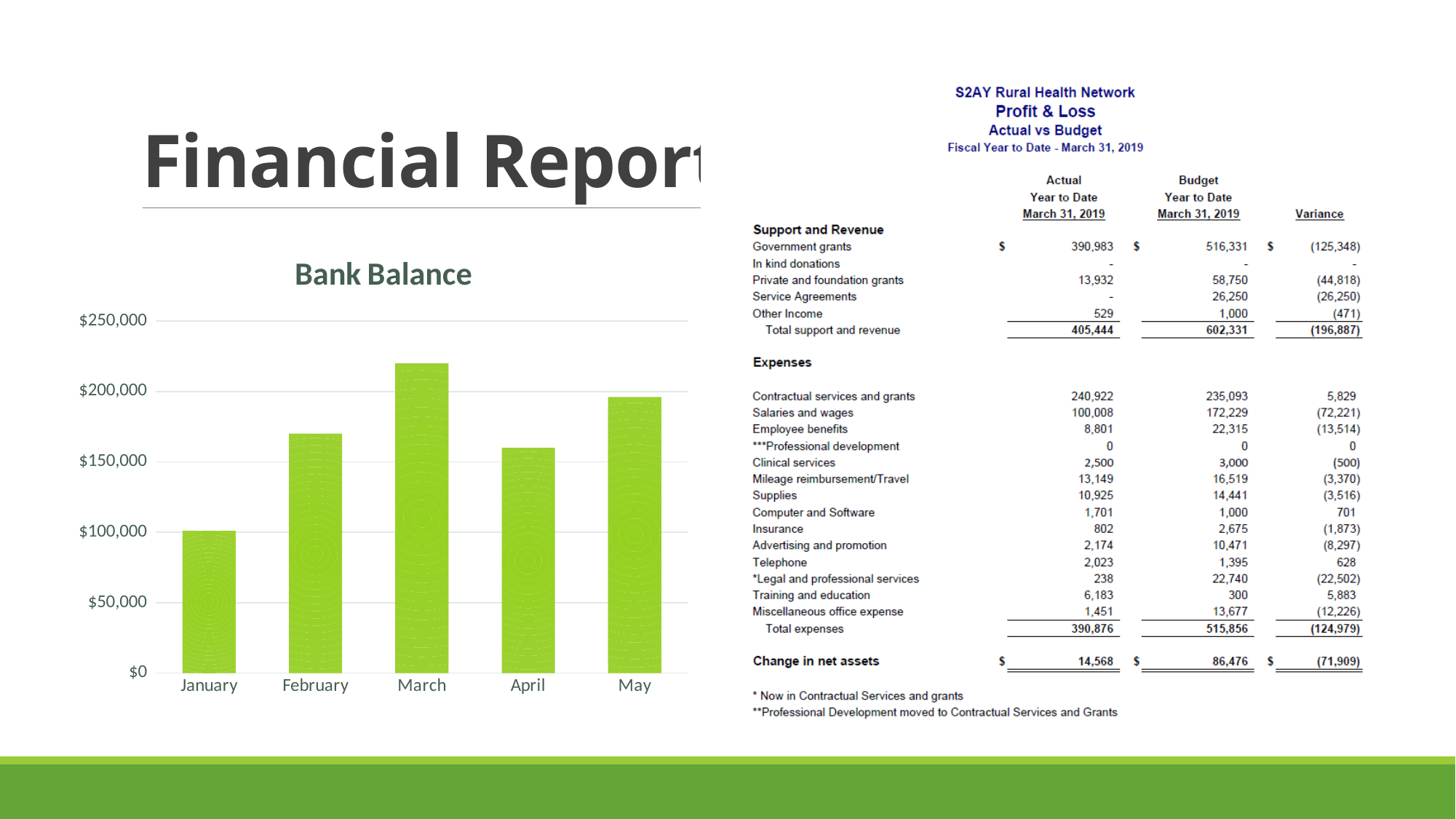
On the Bank Balance chart, is the value for January greater or less than $150,000? less Which month has the lowest bank balance on the Bank Balance chart? January How many months are shown on the Bank Balance chart? 5 On the Bank Balance chart, is the value for April greater or less than $150,000? greater On the Bank Balance chart, does the bank balance rise or fall from January to March? rise On the Bank Balance chart, which month has the larger bank balance, February or April? February What type of chart is the Bank Balance chart? bar chart What is the title of the bar chart on the slide? Bank Balance On the Bank Balance chart, is the value for March greater or less than $200,000? greater On the Bank Balance chart, which month has the larger bank balance, March or May? March Which month has the highest bank balance on the Bank Balance chart? March